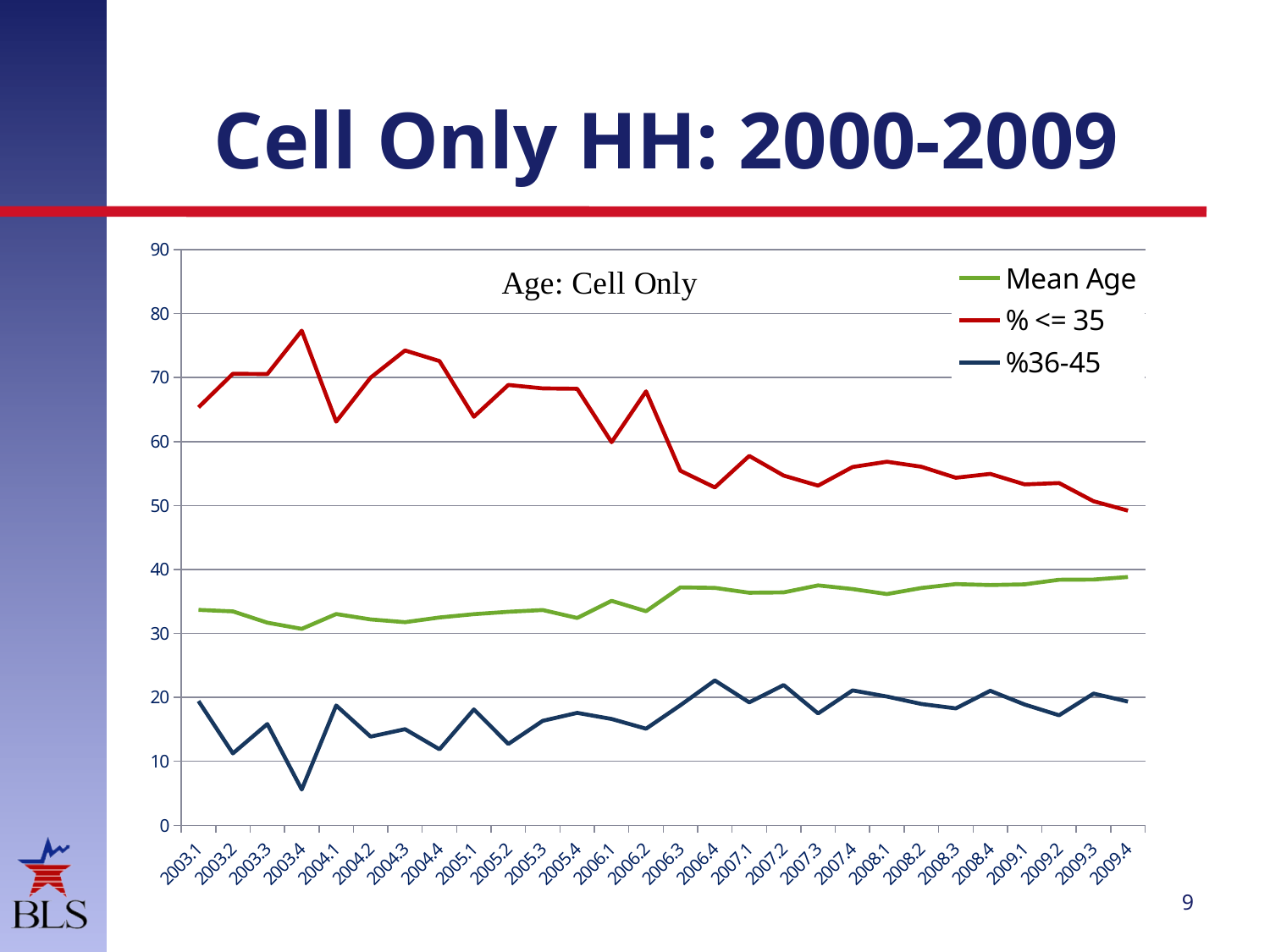
In which quarter does the %36-45 series reach its lowest value? 2003.4 How many quarterly points are plotted along the x axis? 28 At 2003.1, which is larger: % <= 35 or %36-45? % <= 35 Does the % <= 35 series generally rise or fall from 2003.1 to 2009.4? fall Is the Mean Age value at 2009.4 greater or less than 40? less Which series is drawn in red? % <= 35 What is the title of the chart? Age: Cell Only Is the value of % <= 35 at 2003.4 greater or less than 70? greater How many series does the legend list? 3 Is the value of %36-45 at 2003.4 greater or less than 10? less What kind of chart is shown on the slide? line chart In which quarter does the % <= 35 series reach its highest value? 2003.4